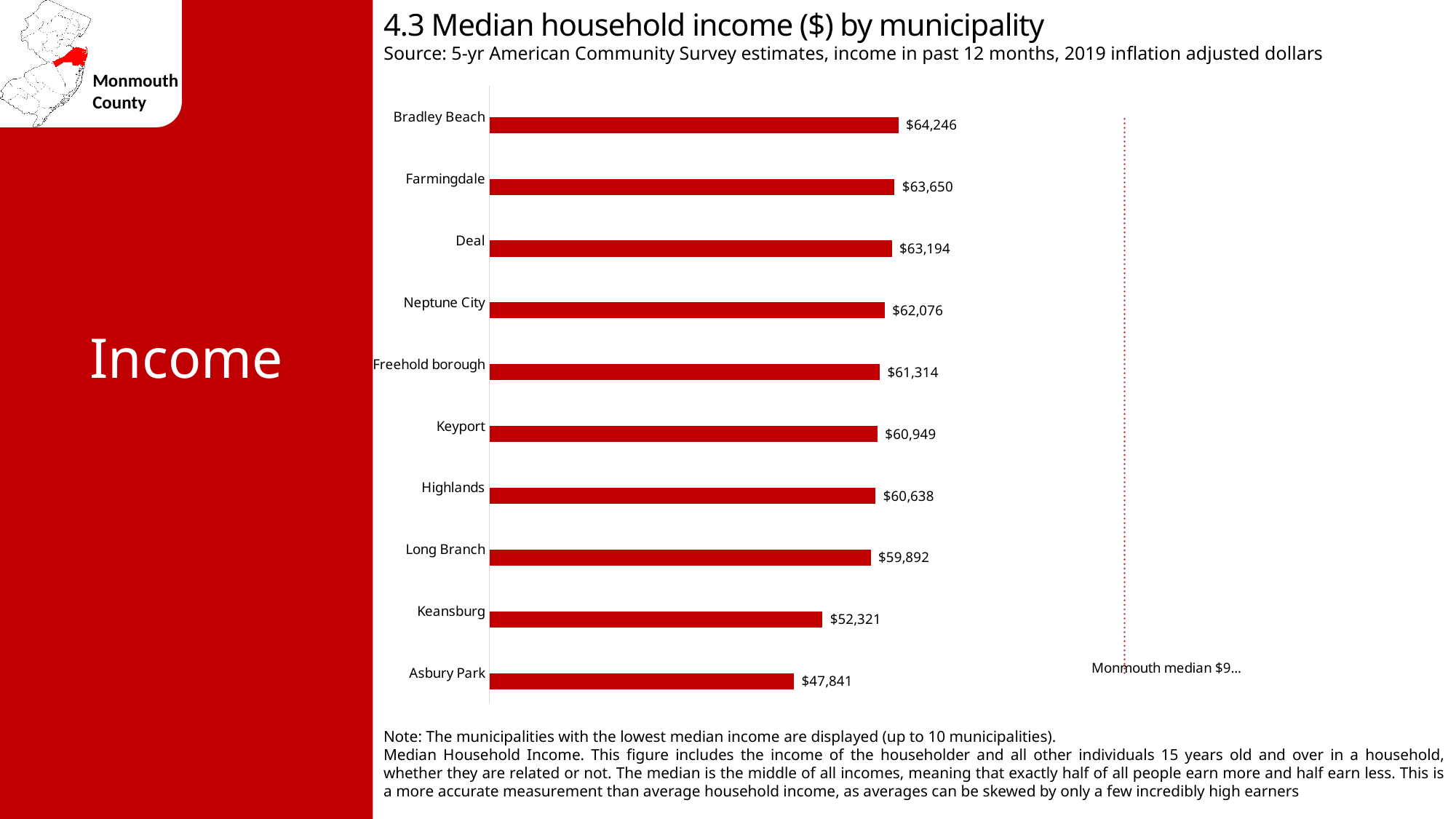
What is the median household income for Keansburg? $52,321 How many municipalities are shown on the chart? 10 What is the difference between the median household income of Bradley Beach and Asbury Park? $16,405 What is the median household income for Highlands? $60,638 Which has a higher median household income, Neptune City or Keyport? Neptune City Which has a higher median household income, Asbury Park or Keansburg? Keansburg Which municipality has the lowest median household income shown on the chart? Asbury Park What is the difference between the median household income of Long Branch and Keansburg? $7,571 Which municipality has the highest median household income shown on the chart? Bradley Beach What kind of chart is used to show median household income by municipality? Bar chart What is the title of the chart? 4.3 Median household income ($) by municipality What is the median household income for Bradley Beach? $64,246